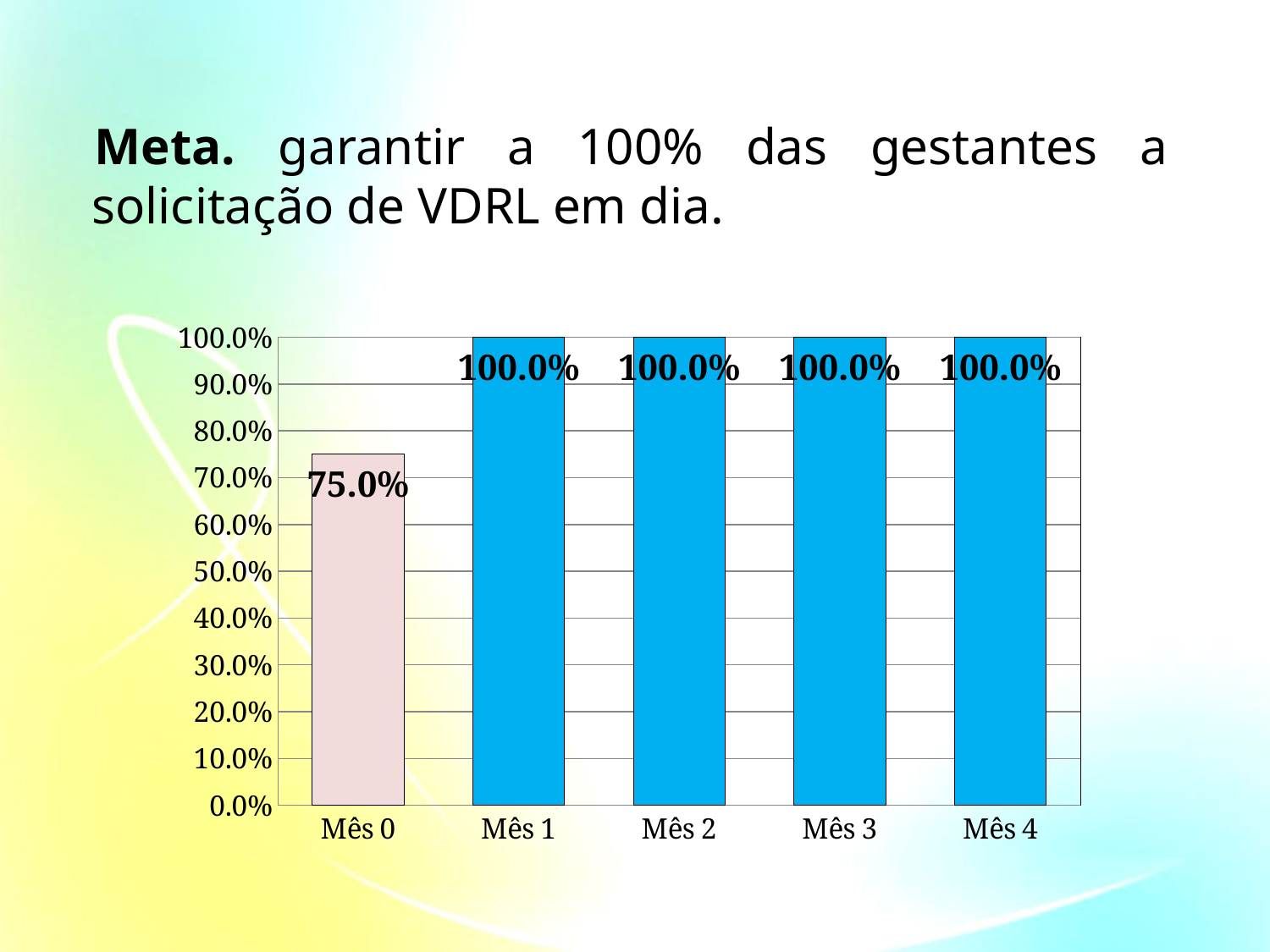
What is the value for Mês 4? 100.0% How many categories are shown on the x axis? 5 What is the value for Mês 2? 100.0% Do the values rise or fall from Mês 0 to Mês 1? rise What colour is the bar for Mês 0? pink What is the value for Mês 0? 75.0% What kind of chart is shown on the slide? bar chart Is the value for Mês 0 greater or less than 80.0%? less Which is larger, the value for Mês 0 or the value for Mês 3? Mês 3 How many categories have a value of 100.0%? 4 What is the difference between the values for Mês 1 and Mês 0? 25.0% Which category has the lowest value? Mês 0